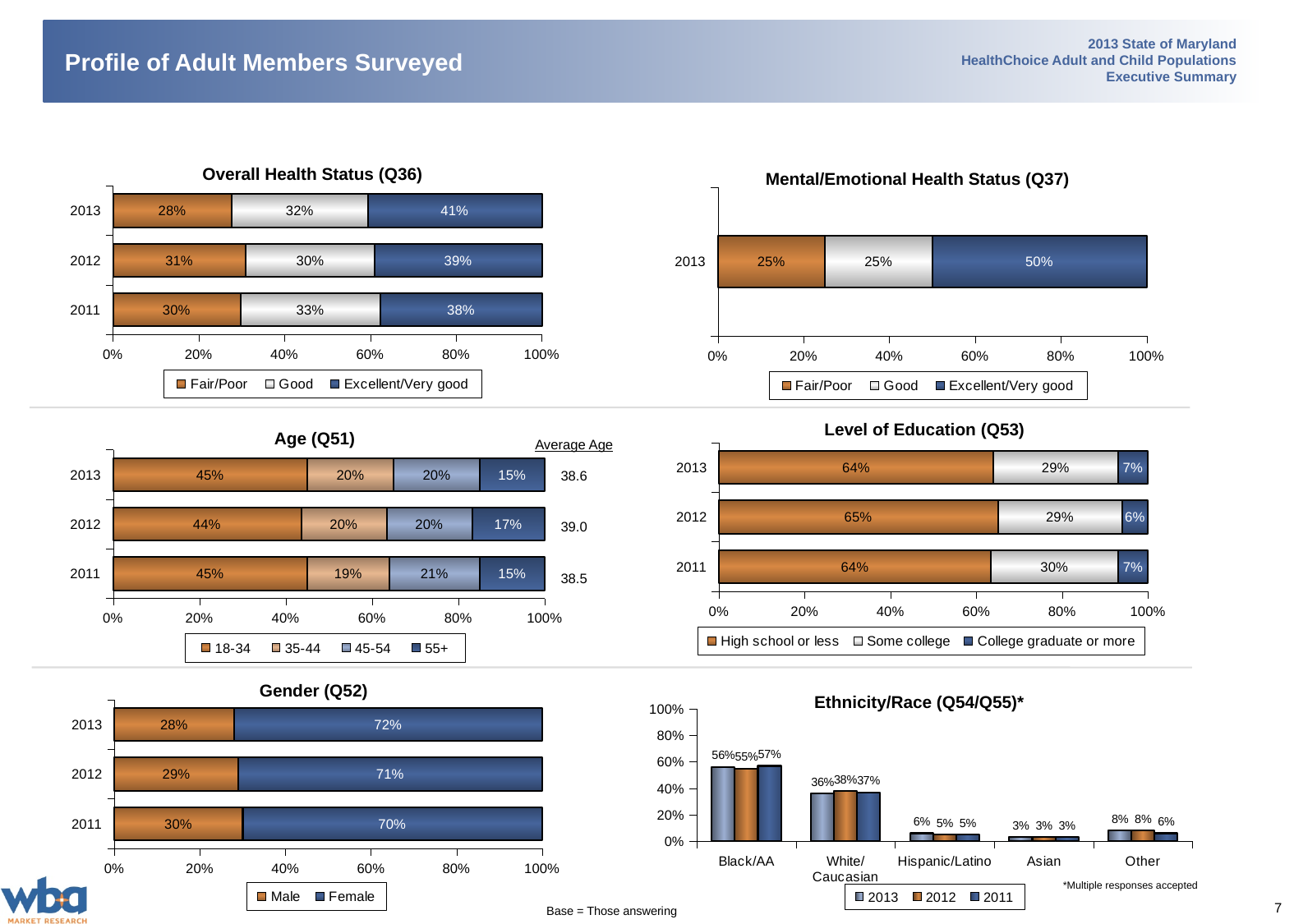
In the Overall Health Status (Q36) chart, what percentage of 2013 respondents rated their health Excellent/Very good? 41% In the Mental/Emotional Health Status (Q37) chart, what is the value for Excellent/Very good in 2013? 50% In the Ethnicity/Race (Q54/Q55) chart, how many ethnicity categories are shown on the x axis? 5 What kind of chart is the Overall Health Status (Q36) chart? Stacked bar chart In the Age (Q51) chart, how many series does the legend list? 4 In the Ethnicity/Race (Q54/Q55) chart, is the 2013 value for Black/AA larger or smaller than the 2013 value for White/Caucasian? larger In the Ethnicity/Race (Q54/Q55) chart, which category has the lowest values? Asian In the Gender (Q52) chart, what is the Male value for 2011? 30% In the Gender (Q52) chart, which year has the highest Female percentage? 2013 In the Ethnicity/Race (Q54/Q55) chart, what is the 2012 value for White/Caucasian? 38% In the Level of Education (Q53) chart, what is the difference between the High school or less values for 2012 and 2013? 1% In the Age (Q51) chart, what is the average age shown for 2012? 39.0